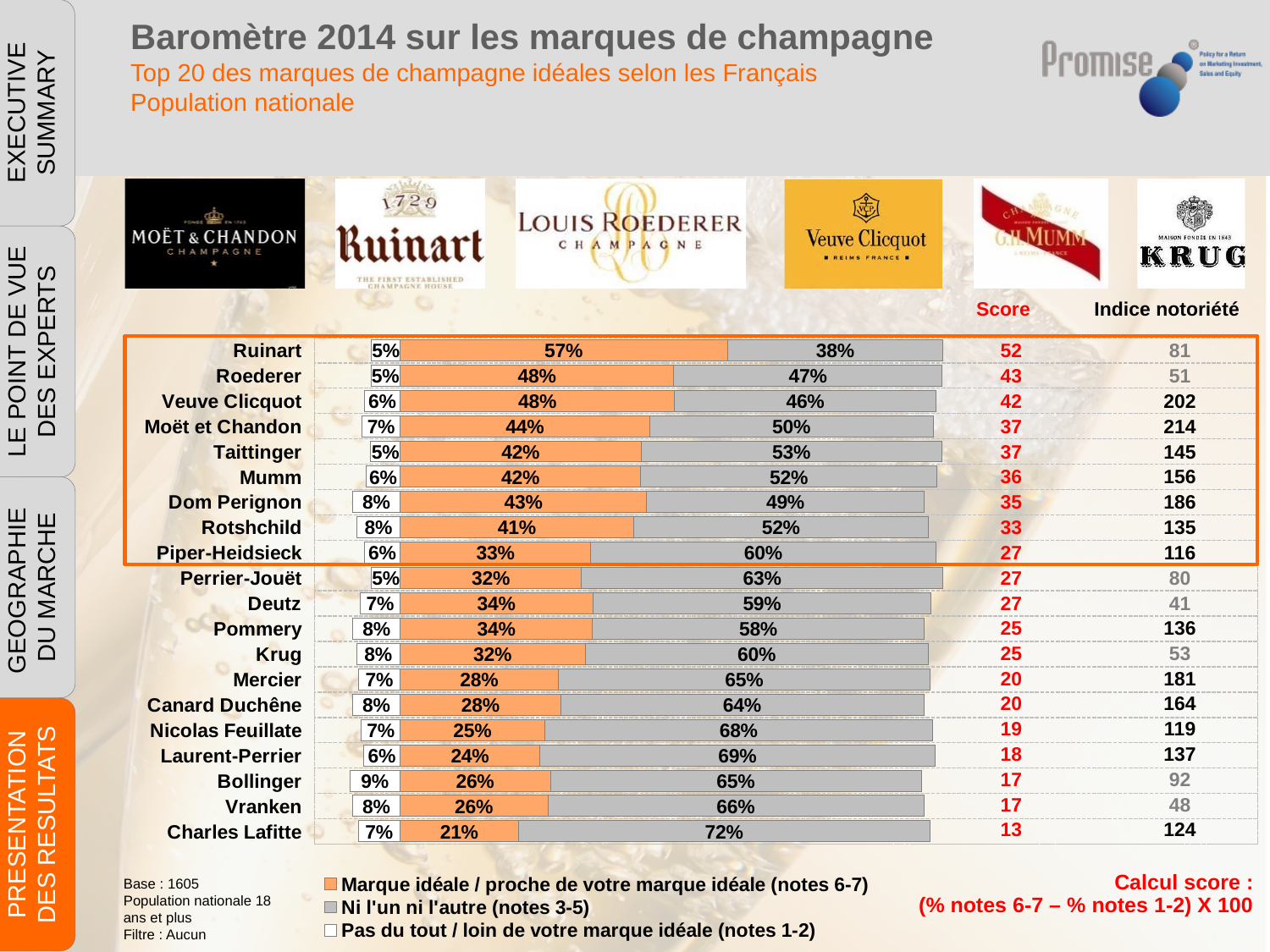
Which colour represents 'Marque idéale / proche de votre marque idéale (notes 6-7)' in the chart? Orange What is the 'Ni l'un ni l'autre (notes 3-5)' value for Charles Lafitte? 72% Which brand has the lowest 'Marque idéale / proche de votre marque idéale (notes 6-7)' percentage? Charles Lafitte What kind of chart is used to show the brand ratings? Stacked bar chart What is the total of the three segments of the Ruinart bar? 100% How many champagne brands are shown in the chart? 20 What is the 'Pas du tout / loin de votre marque idéale (notes 1-2)' value for Bollinger? 9% Which brand has the highest 'Marque idéale / proche de votre marque idéale (notes 6-7)' percentage? Ruinart What percentage of respondents rated Ruinart as 'Marque idéale / proche de votre marque idéale (notes 6-7)'? 57% How many series does the chart legend list? 3 What is the difference in percentage points between Ruinart's and Roederer's 'Marque idéale (notes 6-7)' values? 9 percentage points Which has a larger 'Marque idéale (notes 6-7)' value, Piper-Heidsieck or Mercier? Piper-Heidsieck